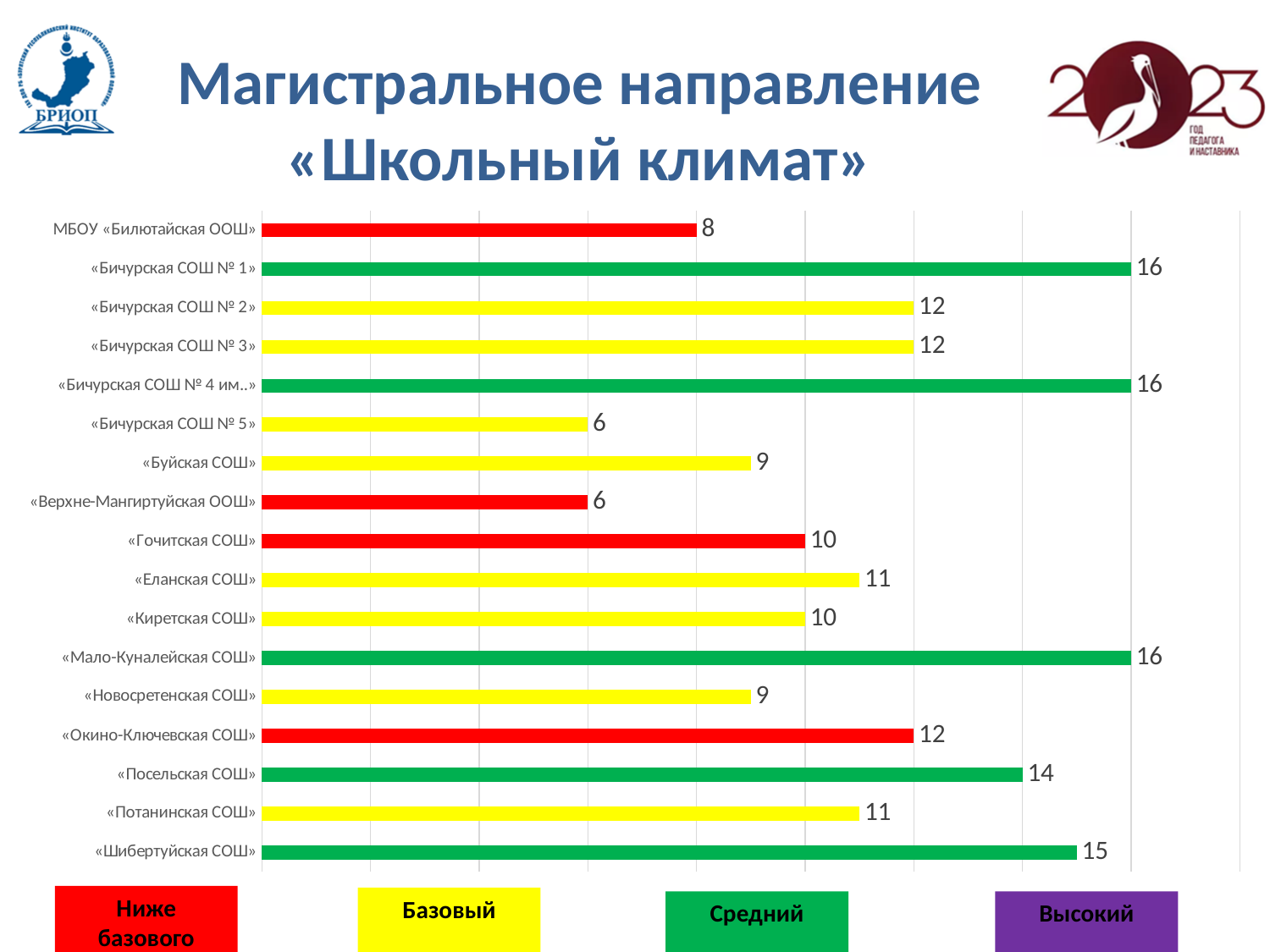
What colour is the bar for МБОУ «Билютайская ООШ»? Red How many schools (categories) are shown in the chart? 17 What is the value for «Посельская СОШ»? 14 What kind of chart is shown on the slide? Bar chart What is the value for «Гочитская СОШ»? 10 What is the value for «Шибертуйская СОШ»? 15 What is the difference between the values for «Посельская СОШ» and «Еланская СОШ»? 3 What is the value for «Бичурская СОШ № 5»? 6 What is the highest value shown in the chart? 16 What is the difference between the values for «Бичурская СОШ № 1» and «Бичурская СОШ № 5»? 10 Which has the larger value, «Потанинская СОШ» or «Киретская СОШ»? «Потанинская СОШ» Which has the larger value, «Окино-Ключевская СОШ» or «Буйская СОШ»? «Окино-Ключевская СОШ»